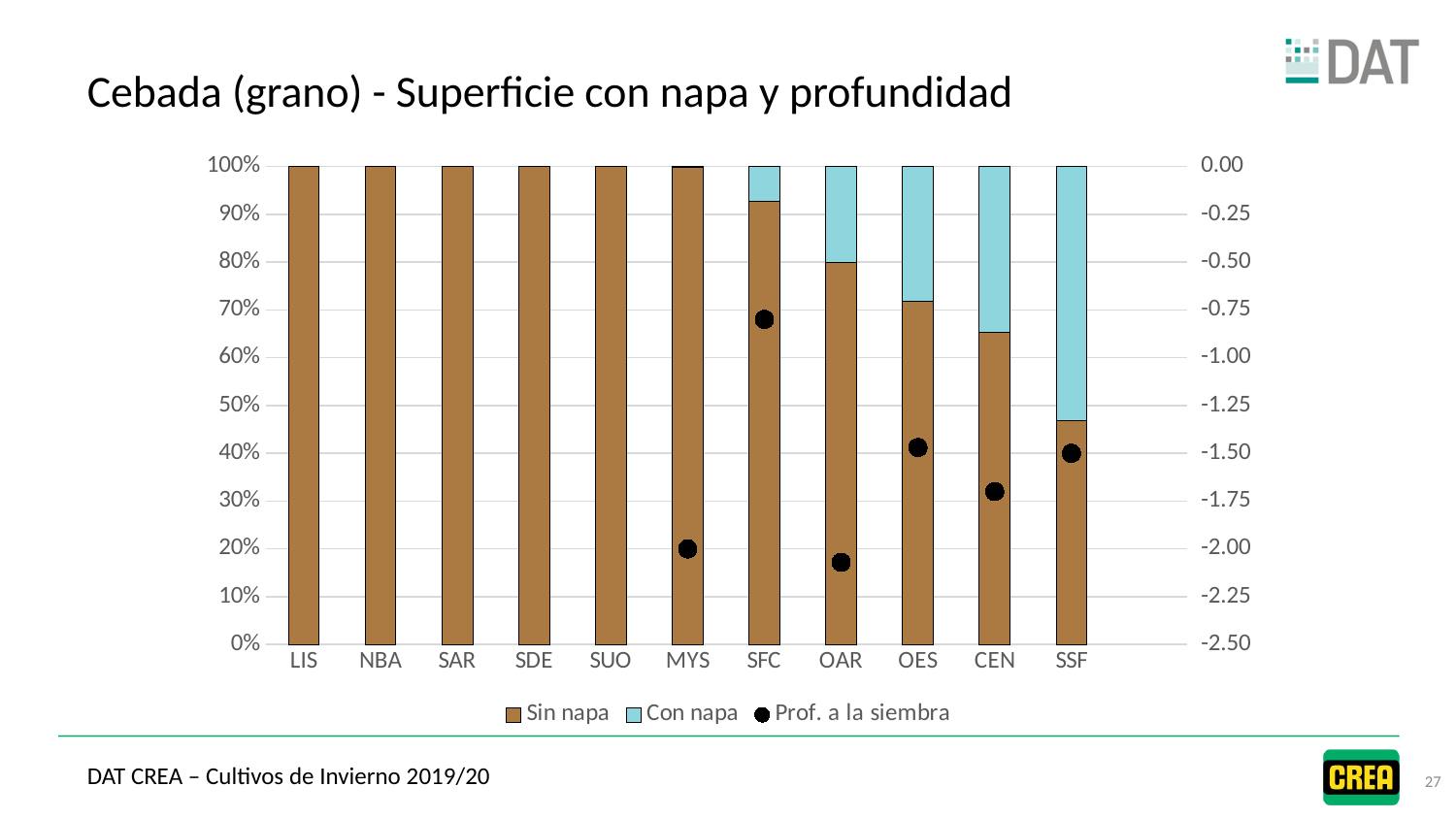
Is the Sin napa share for CEN greater or less than 60%? greater Is the Prof. a la siembra value for CEN greater or less than -1.50? less Which category has the lowest Sin napa share? SSF How many series does the legend list? 3 Is the Sin napa share for SSF greater or less than 50%? less Which category has the largest Con napa share? SSF How many categories are shown on the x axis? 11 Which category has the highest (shallowest) Prof. a la siembra value? SFC Which has the larger Con napa share, CEN or OES? CEN What is the title of the chart? Cebada (grano) - Superficie con napa y profundidad What kind of chart is shown on the slide? Stacked bar chart with a dot series